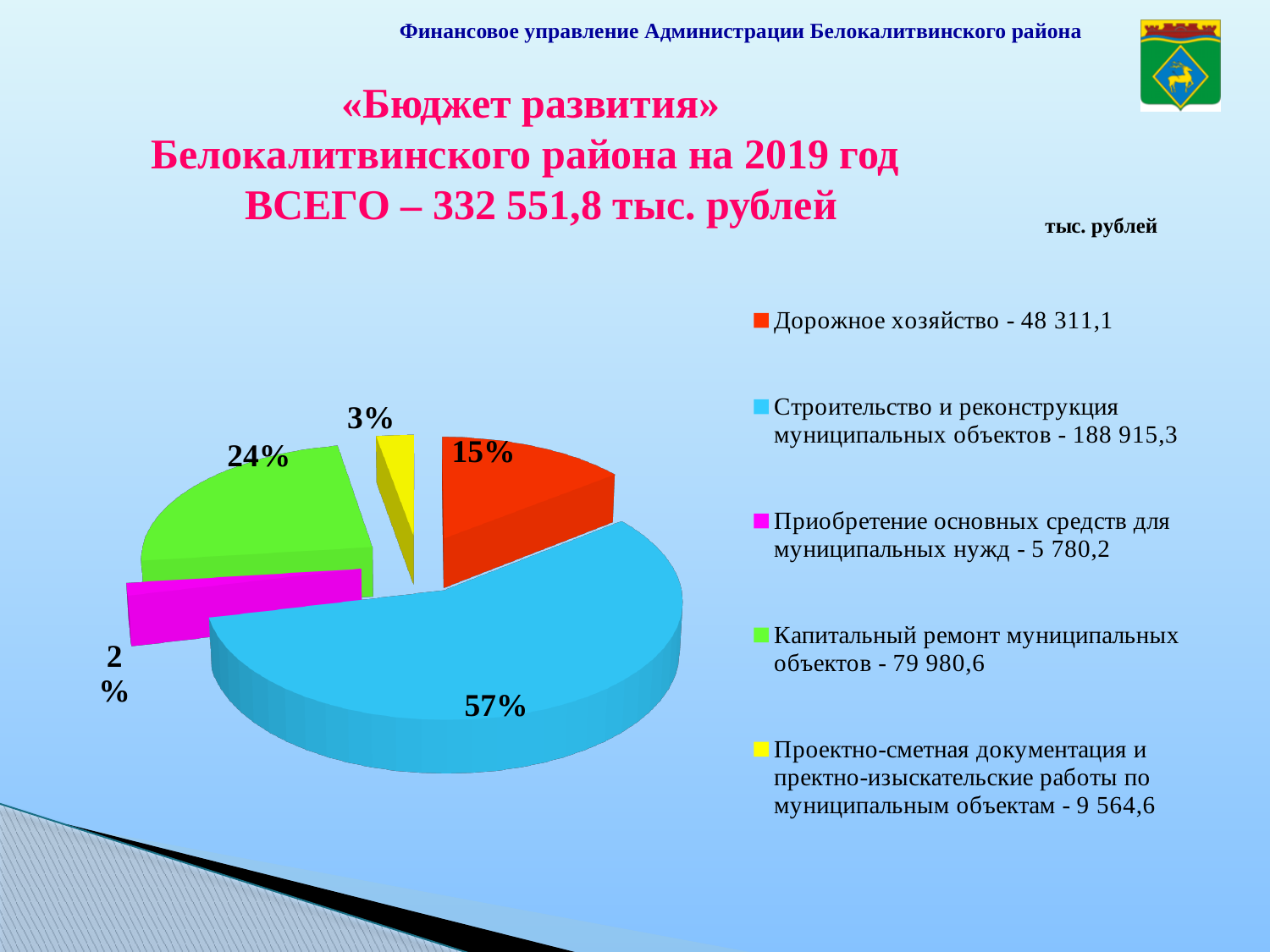
What colour is the slice for «Проектно-сметная документация и пректно-изыскательские работы по муниципальным объектам»? yellow What share of the pie does «Дорожное хозяйство» take? 15% What kind of chart is shown on the slide? pie chart Which category has the largest slice of the pie? Строительство и реконструкция муниципальных объектов What share of the pie does «Строительство и реконструкция муниципальных объектов» take? 57% How many slices does the pie chart have? 5 Which category has the smallest slice of the pie? Приобретение основных средств для муниципальных нужд Which is larger: the share for «Дорожное хозяйство» or the share for «Капитальный ремонт муниципальных объектов»? Капитальный ремонт муниципальных объектов What value (тыс. рублей) is given in the legend for «Приобретение основных средств для муниципальных нужд»? 5 780,2 What value (тыс. рублей) is given in the legend for «Дорожное хозяйство»? 48 311,1 How many entries does the legend list? 5 What share of the pie does «Капитальный ремонт муниципальных объектов» take? 24%